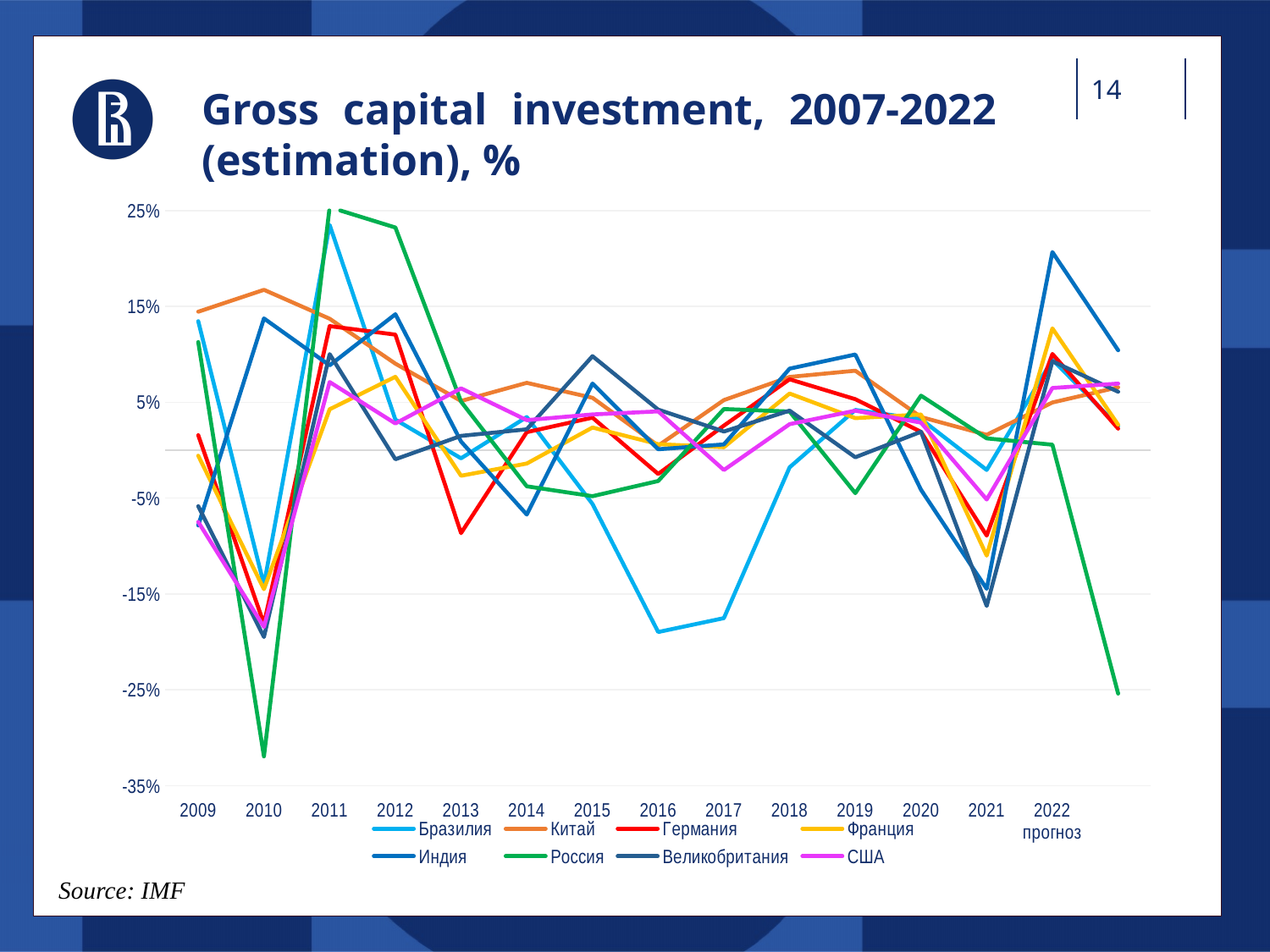
What kind of chart is shown on the slide? line chart Which series has the highest value in 2012? Россия What source is cited for the chart data? IMF Is the value for Россия in 2012 greater or less than 15%? greater Does the value for Бразилия rise or fall from 2009 to 2010? fall Which series has the lowest value in 2010? Россия Is the value for Китай in 2010 greater or less than 15%? greater Which series has the lowest value in 2016? Бразилия How many series does the legend list? 8 Is the value for Бразилия in 2016 greater or less than -15%? less Which series has the highest value in 2010? Китай